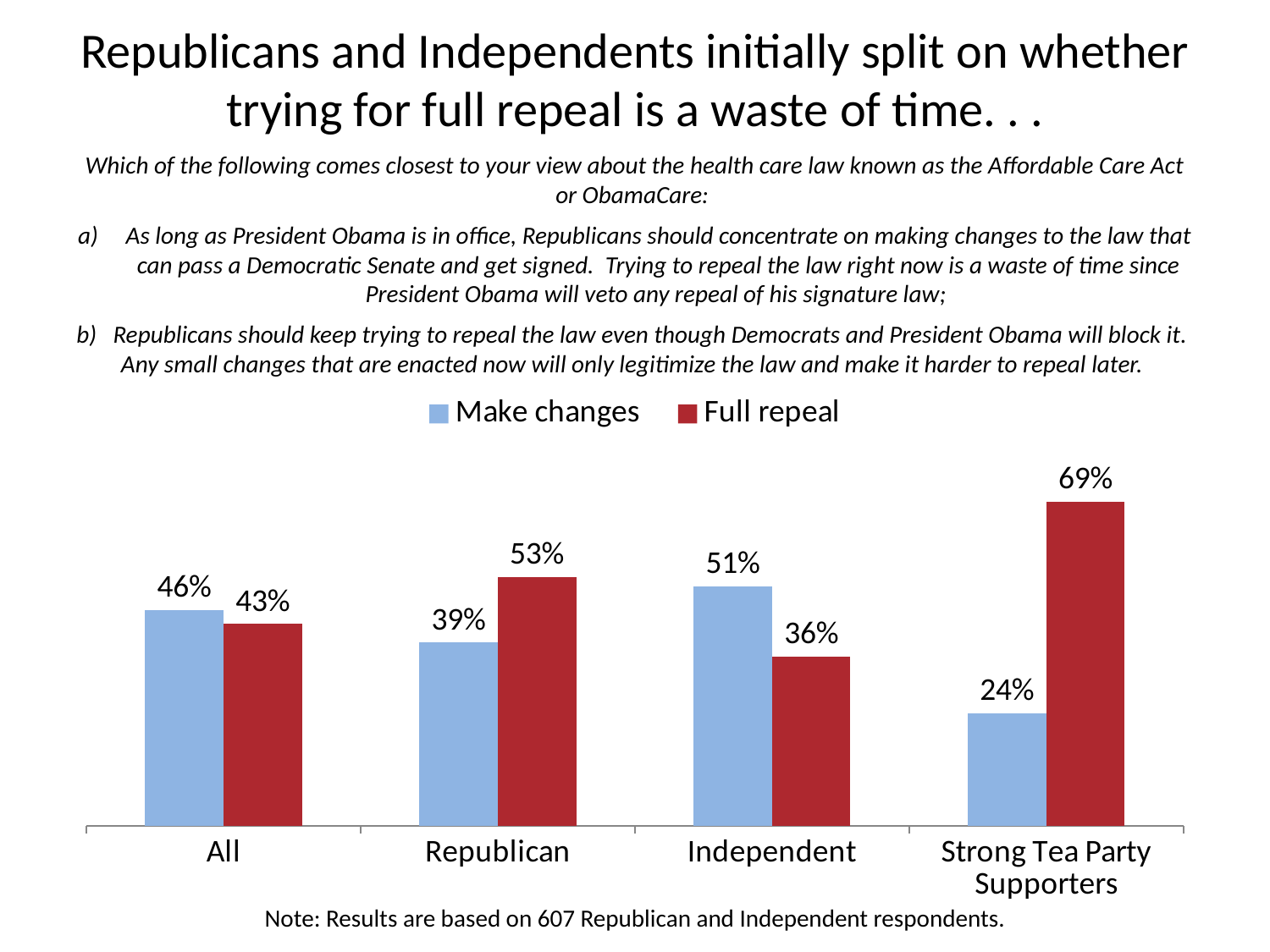
What kind of chart is shown on the slide? Bar chart Which category has the lowest Make changes value? Strong Tea Party Supporters Which category has the highest Full repeal value? Strong Tea Party Supporters How many series does the legend list? 2 What is the value for Full repeal in the All category? 43% What is the value for Make changes among Independents? 51% What is the difference between Full repeal and Make changes among Strong Tea Party Supporters? 45% Among Republicans, which is larger: Make changes or Full repeal? Full repeal How many categories are shown on the x axis? 4 What is the value for Full repeal among Strong Tea Party Supporters? 69% Which colour represents the Full repeal series? Red What is the value for Make changes among Republicans? 39%